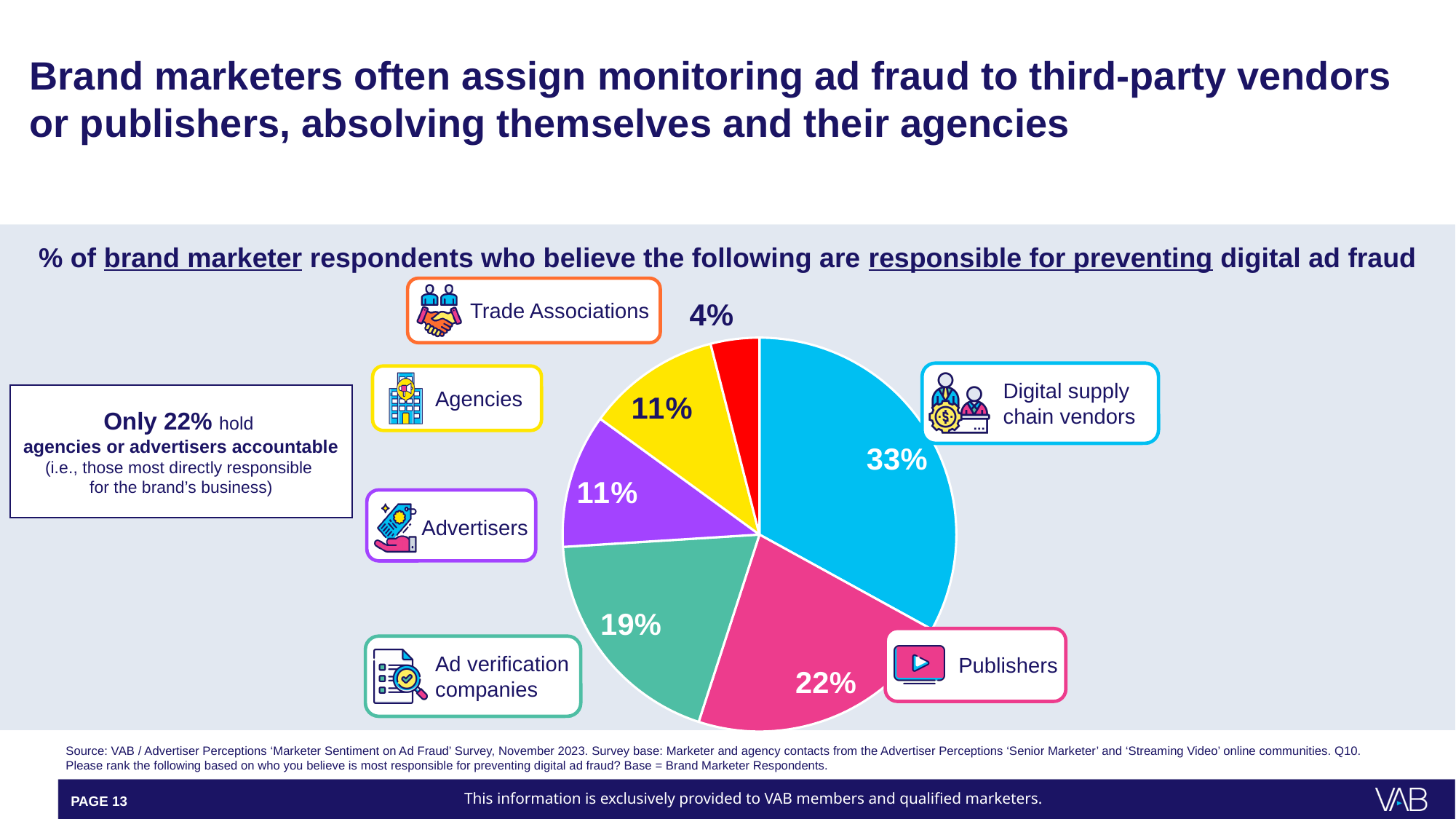
Which category has the smallest slice of the pie chart? Trade Associations Which category has the largest slice of the pie chart? Digital supply chain vendors What is the difference in percentage points between digital supply chain vendors and publishers? 11 What percentage of respondents hold publishers responsible for preventing digital ad fraud? 22% What share of the pie is attributed to ad verification companies? 19% What percentage of respondents believe trade associations are responsible for preventing digital ad fraud? 4% What type of chart is shown on the slide? Pie chart Which is larger: the share for ad verification companies or the share for advertisers? Ad verification companies What colour is the slice representing publishers? Pink What is the combined percentage for agencies and advertisers? 22% How many categories are shown in the pie chart? 6 What percentage of brand marketer respondents believe digital supply chain vendors are responsible for preventing digital ad fraud? 33%